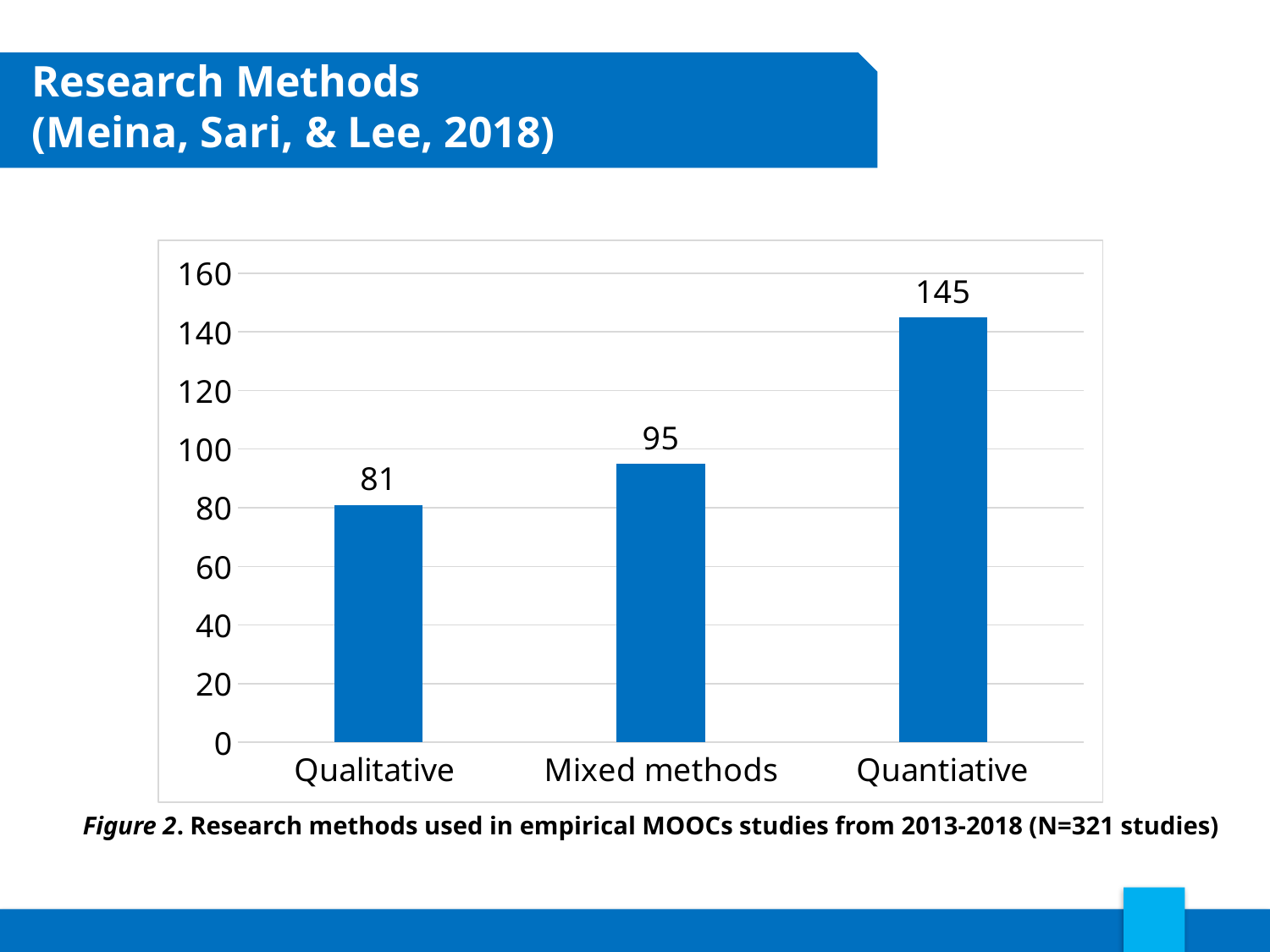
Which is larger, the value for Mixed methods or the value for Qualitative? Mixed methods Which research method has the highest value? Quantiative What is the difference between the values for Mixed methods and Qualitative? 14 What is the difference between the values for Quantiative and Qualitative? 64 Which research method has the lowest value? Qualitative Do the values rise or fall from left to right along the x axis? rise How many categories are shown on the x axis? 3 What is the value for Quantiative? 145 Is the value for Quantiative greater or less than 140? greater What is the value for Qualitative? 81 What kind of chart is shown on the slide? bar chart What is the value for Mixed methods? 95